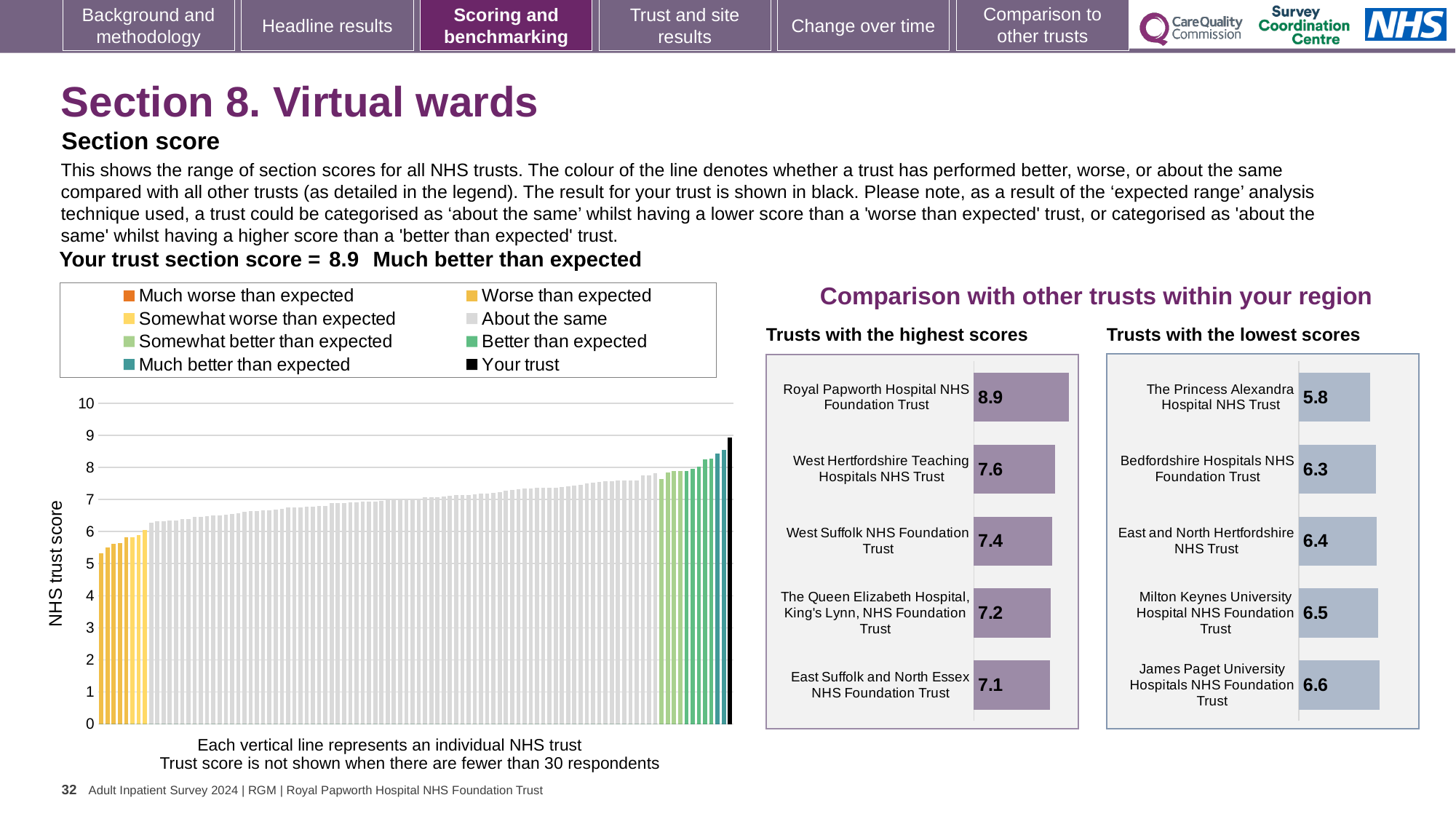
In the large chart on the left, what colour is the bar for 'Your trust'? black In the 'Trusts with the highest scores' chart, what is the score for Royal Papworth Hospital NHS Foundation Trust? 8.9 In the large chart on the left, is the value of the leftmost bar greater or less than 6? less In the 'Trusts with the highest scores' chart, what is the score for West Suffolk NHS Foundation Trust? 7.4 What kind of chart is the large chart on the left showing NHS trust scores? bar chart In the 'Trusts with the lowest scores' chart, which has the higher score: Bedfordshire Hospitals NHS Foundation Trust or James Paget University Hospitals NHS Foundation Trust? James Paget University Hospitals NHS Foundation Trust In the large chart on the left, do the trust scores rise or fall from left to right? rise In the large chart on the left, how many entries does the legend list? 8 In the 'Trusts with the highest scores' chart, how many trusts are shown? 5 In the 'Trusts with the lowest scores' chart, what is the score for Milton Keynes University Hospital NHS Foundation Trust? 6.5 In the 'Trusts with the highest scores' chart, what is the difference between the scores of Royal Papworth Hospital NHS Foundation Trust and East Suffolk and North Essex NHS Foundation Trust? 1.8 In the 'Trusts with the lowest scores' chart, which trust has the lowest score? The Princess Alexandra Hospital NHS Trust